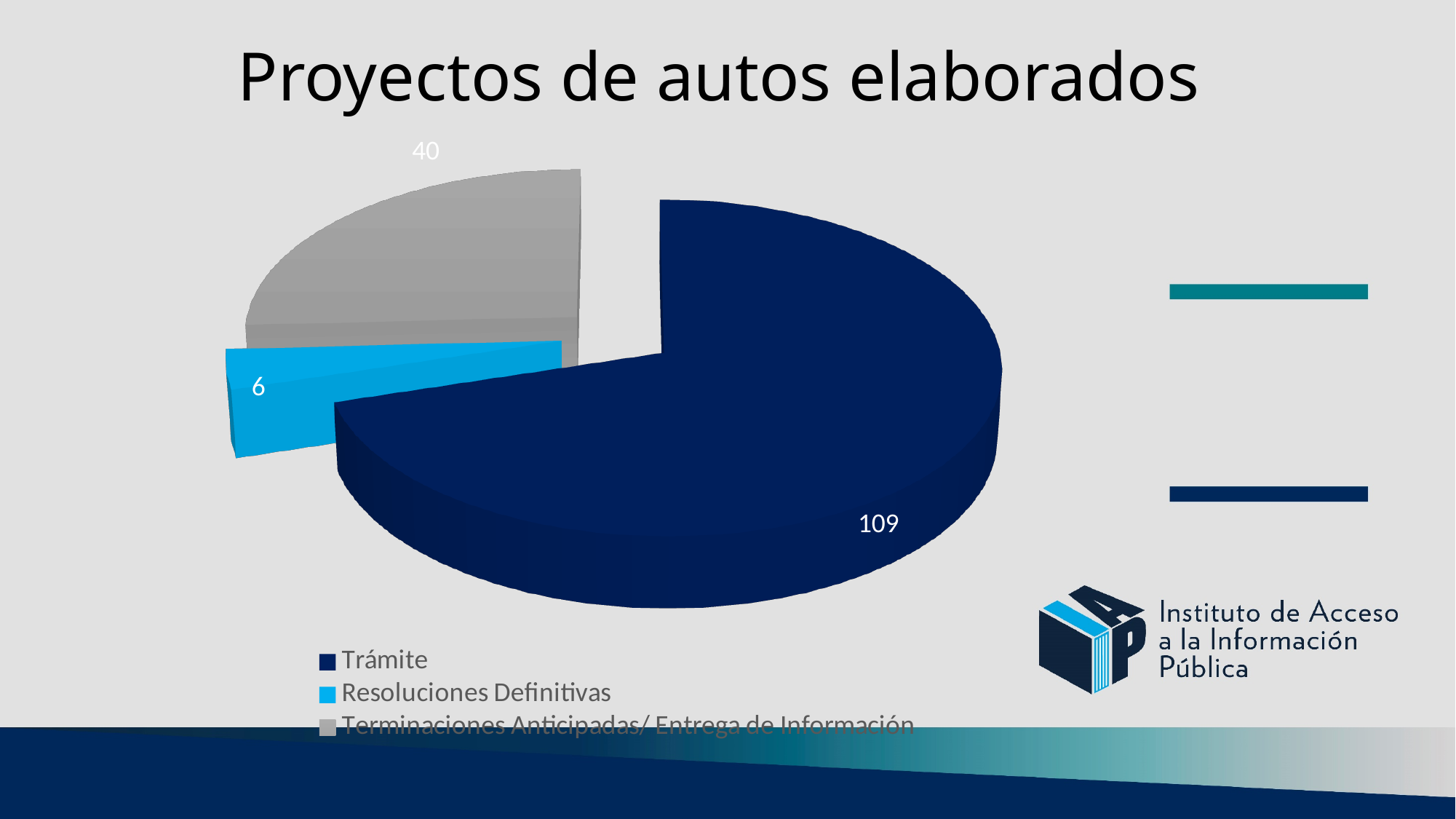
What kind of chart is shown on the slide? Pie chart What is the difference between the values for Terminaciones Anticipadas/ Entrega de Información and Resoluciones Definitivas? 34 Which category has the smallest slice of the pie? Resoluciones Definitivas How many categories does the pie chart have? 3 What is the difference between the values for Trámite and Terminaciones Anticipadas/ Entrega de Información? 69 What is the value for Resoluciones Definitivas? 6 What is the title of the chart? Proyectos de autos elaborados Which is larger, the value for Resoluciones Definitivas or the value for Terminaciones Anticipadas/ Entrega de Información? Terminaciones Anticipadas/ Entrega de Información Which category has the largest slice of the pie? Trámite What is the value for Terminaciones Anticipadas/ Entrega de Información? 40 What is the value for Trámite? 109 What is the total of all the slices in the pie chart? 155